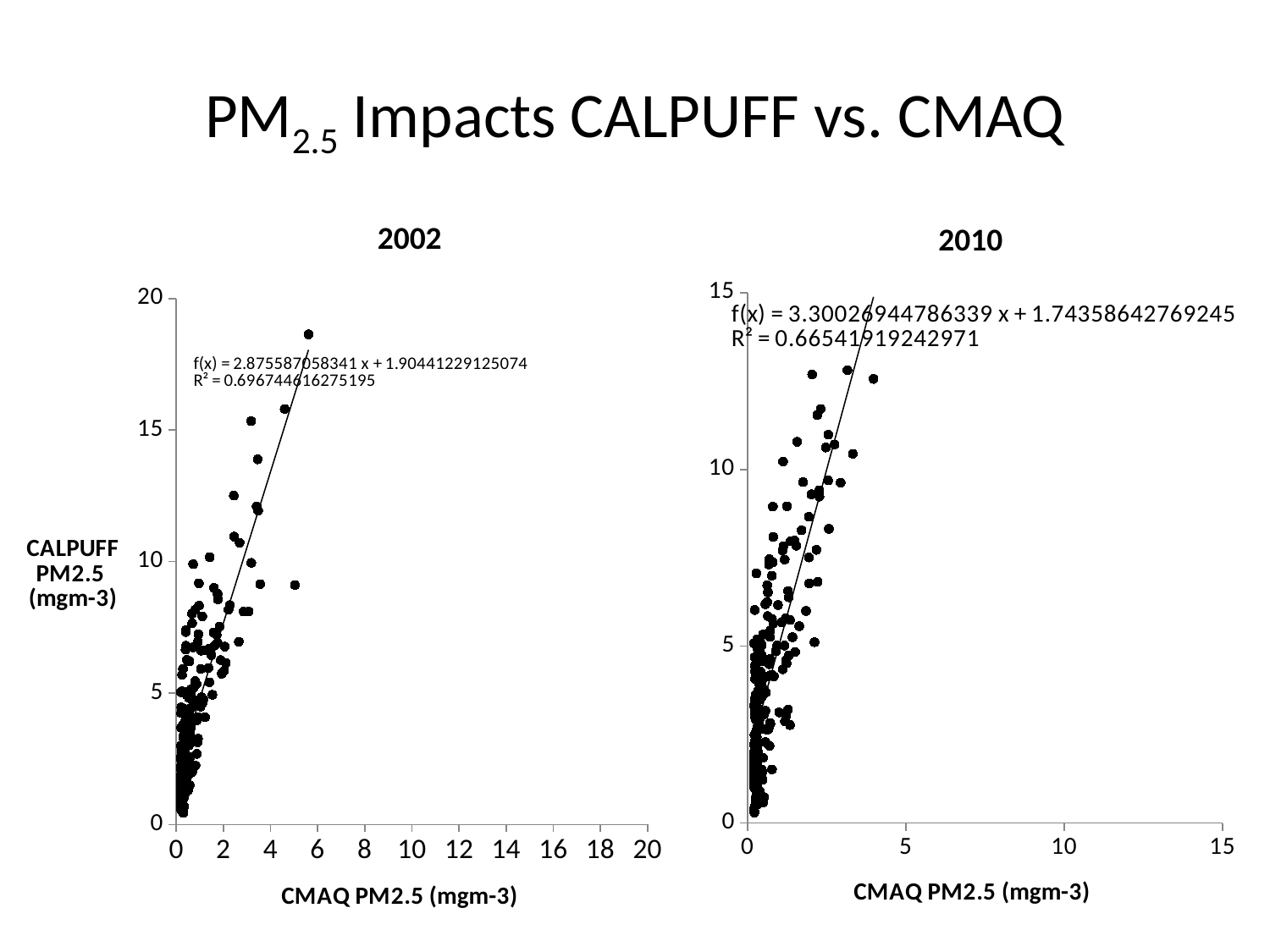
In the 2002 chart, do the CALPUFF PM2.5 values generally rise or fall as CMAQ PM2.5 increases? rise In the 2002 chart, what is the slope of the fitted line f(x)? 2.875587058341 In the 2010 chart, what is the R² value printed for the trendline? 0.66541919242971 In the 2010 chart, is the highest plotted CALPUFF PM2.5 value greater or less than 10? greater What is the x-axis label of the 2010 chart? CMAQ PM2.5 (mgm-3) Which chart has the steeper fitted-line slope, 2002 or 2010? 2010 In the 2002 chart, is the highest plotted CALPUFF PM2.5 value greater or less than 15? greater What kind of chart is the 2010 chart? scatter chart In the 2010 chart, what is the intercept of the fitted line f(x)? 1.74358642769245 What kind of chart is the 2002 chart? scatter chart Which chart has the higher R² value, 2002 or 2010? 2002 In the 2002 chart, what is the R² value printed for the trendline? 0.696744616275195